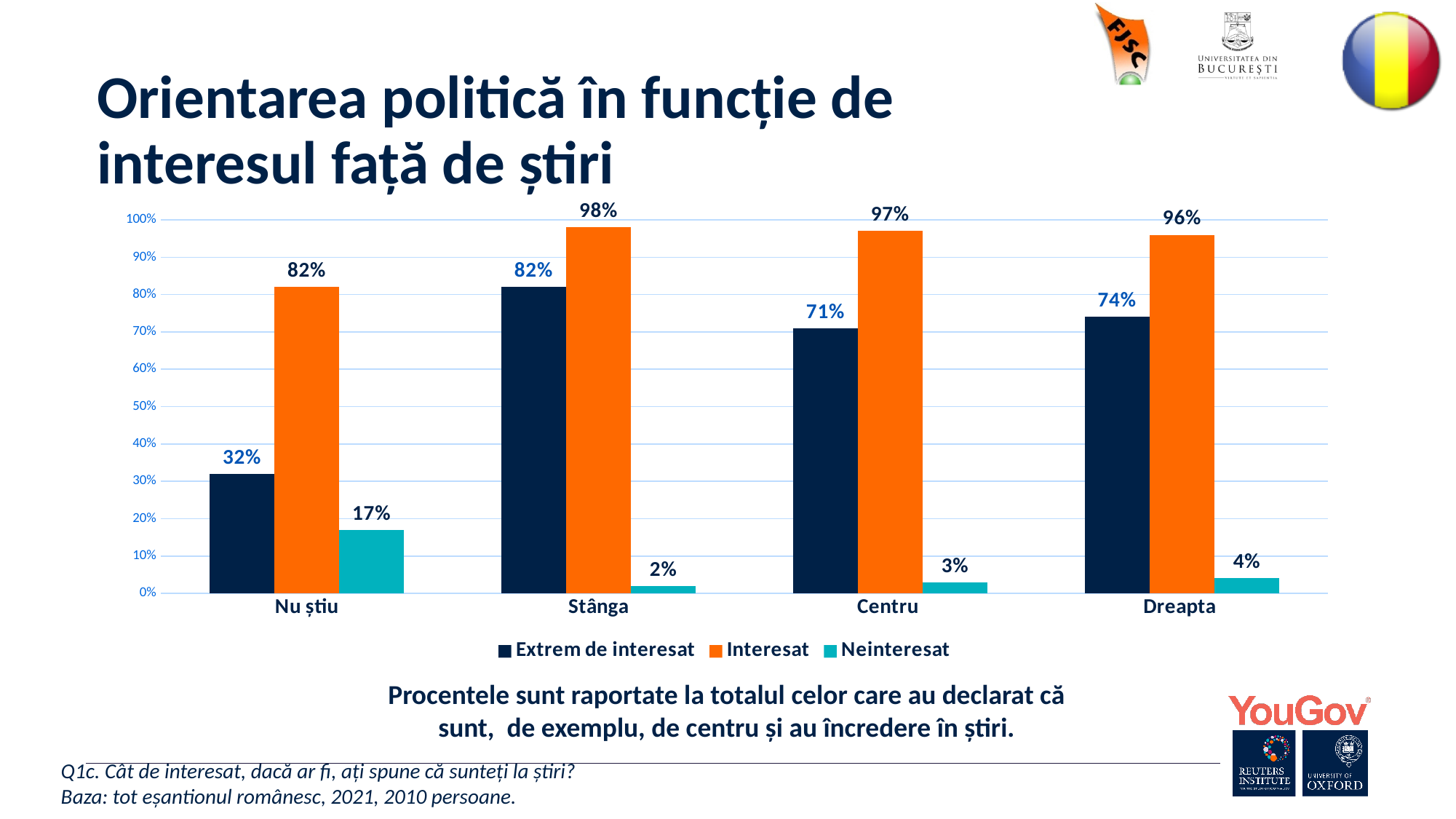
What is the value for "Neinteresat" in the "Dreapta" category? 4% What is the value for "Extrem de interesat" in the "Nu știu" category? 32% Which category has the highest value for "Neinteresat"? Nu știu Which series is shown in orange? Interesat Which is larger: the "Extrem de interesat" value for "Centru" or for "Dreapta"? Dreapta Which category has the lowest value for "Extrem de interesat"? Nu știu How many series does the legend list? 3 What is the difference between the "Interesat" and "Extrem de interesat" values in the "Centru" category? 26% How many categories are shown on the x axis? 4 Is the value for "Extrem de interesat" in the "Stânga" category greater or less than 70%? greater What kind of chart is shown on the slide? bar chart What is the value for "Interesat" in the "Stânga" category? 98%